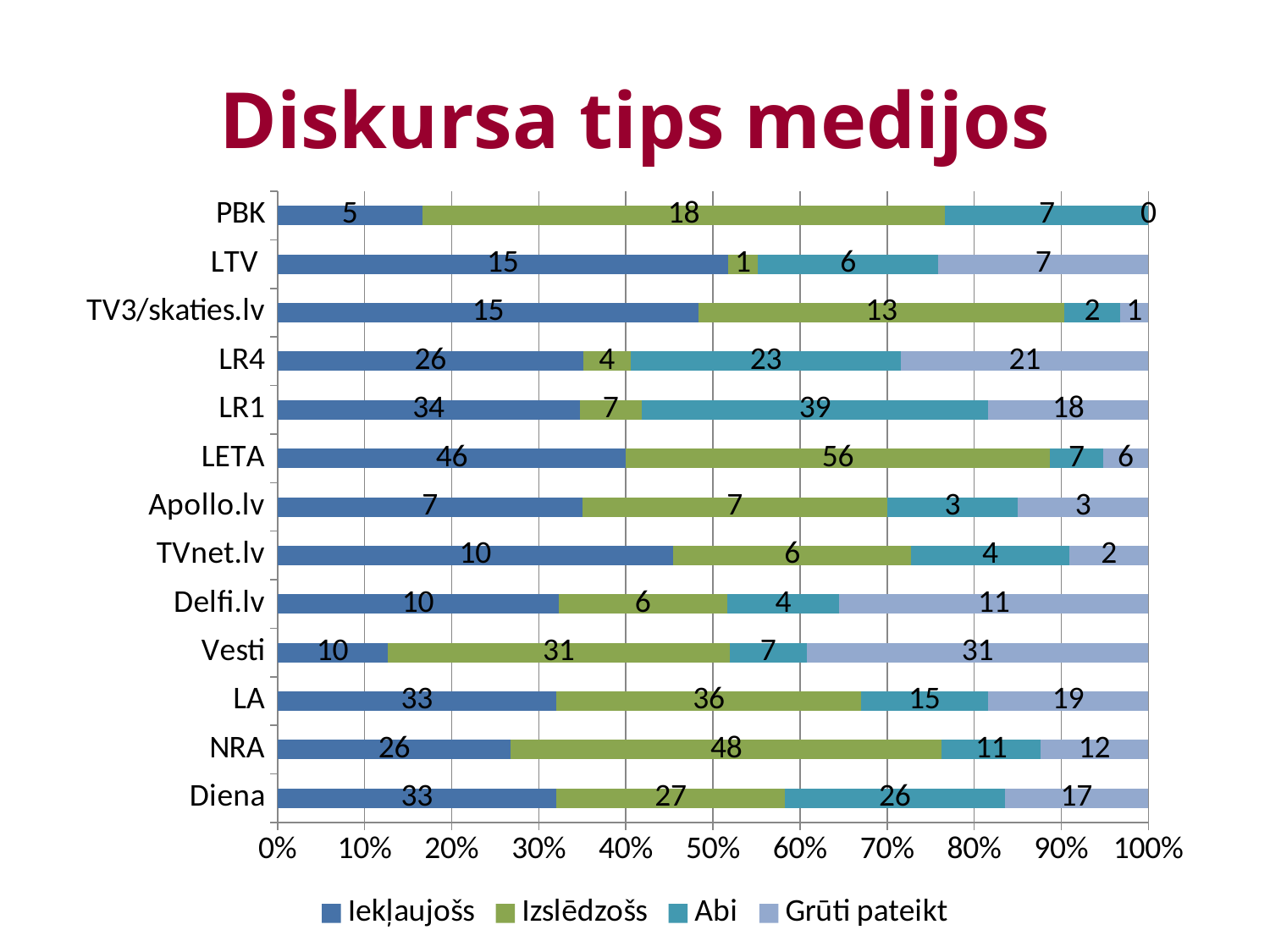
What is the total of the four values in the Diena bar? 103 What kind of chart is shown on the slide? Stacked bar chart What is the Abi value for LR1? 39 What is the difference between the Izslēdzošs values for LETA and NRA? 8 What is the Grūti pateikt value for Vesti? 31 Which is larger, the Abi value for Diena or the Abi value for LA? Diena Which media outlet has the lowest Iekļaujošs value? PBK Which media outlet has the highest Izslēdzošs value? LETA How many media outlets are shown on the chart? 13 How many series does the legend list? 4 What is the Iekļaujošs value for LETA? 46 What is the Izslēdzošs value for NRA? 48